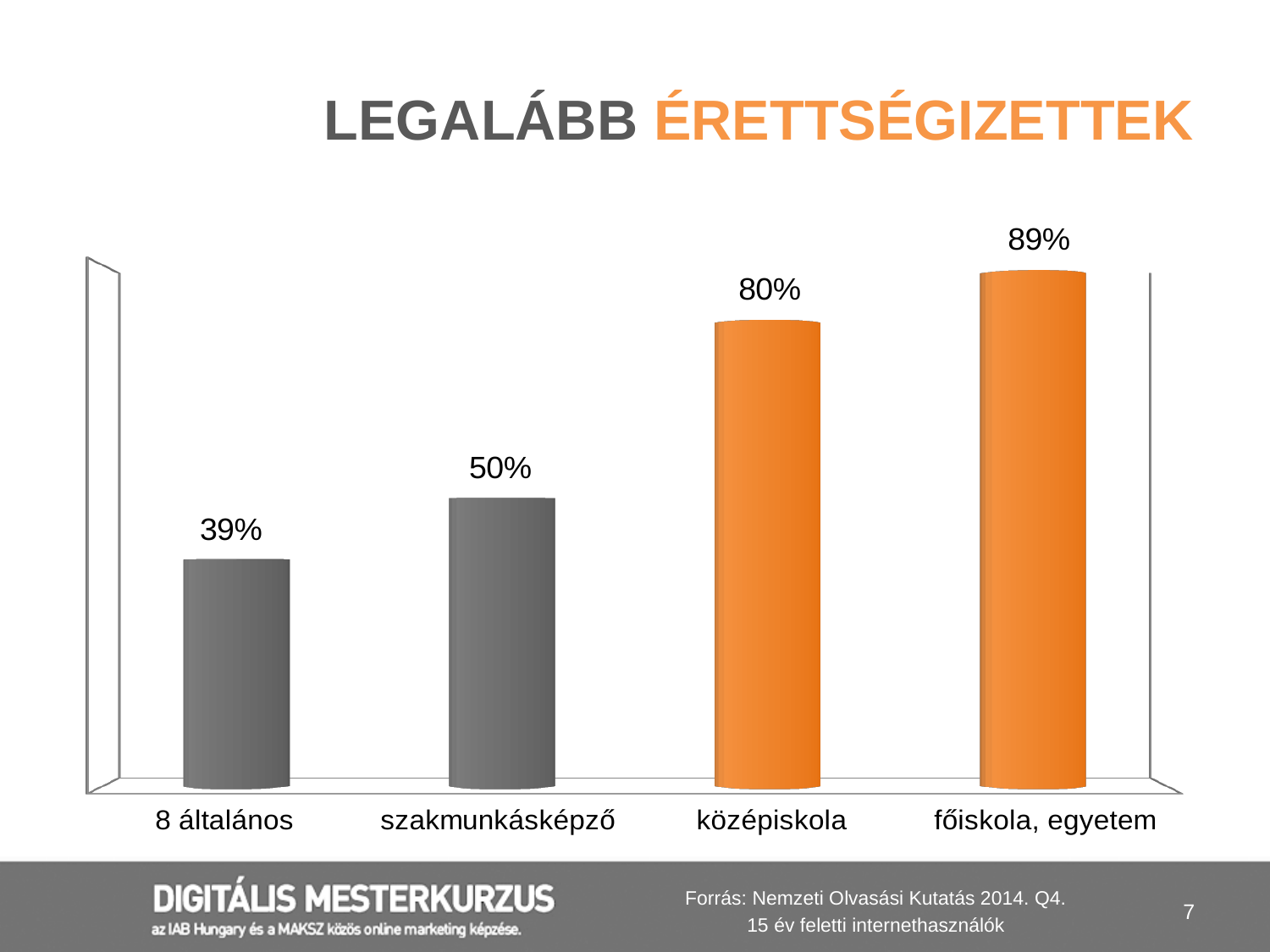
Which category has the highest value? főiskola, egyetem Which category has the lowest value? 8 általános Do the values rise or fall from left to right along the x axis? rise Which is larger, the value for középiskola or the value for szakmunkásképző? középiskola What kind of chart is shown on the slide? bar chart What is the value for főiskola, egyetem? 89% What is the difference between the values for szakmunkásképző and 8 általános? 11% What is the value for középiskola? 80% How many categories are shown in the chart? 4 What is the value for 8 általános? 39% What is the difference between the values for főiskola, egyetem and középiskola? 9% What is the value for szakmunkásképző? 50%